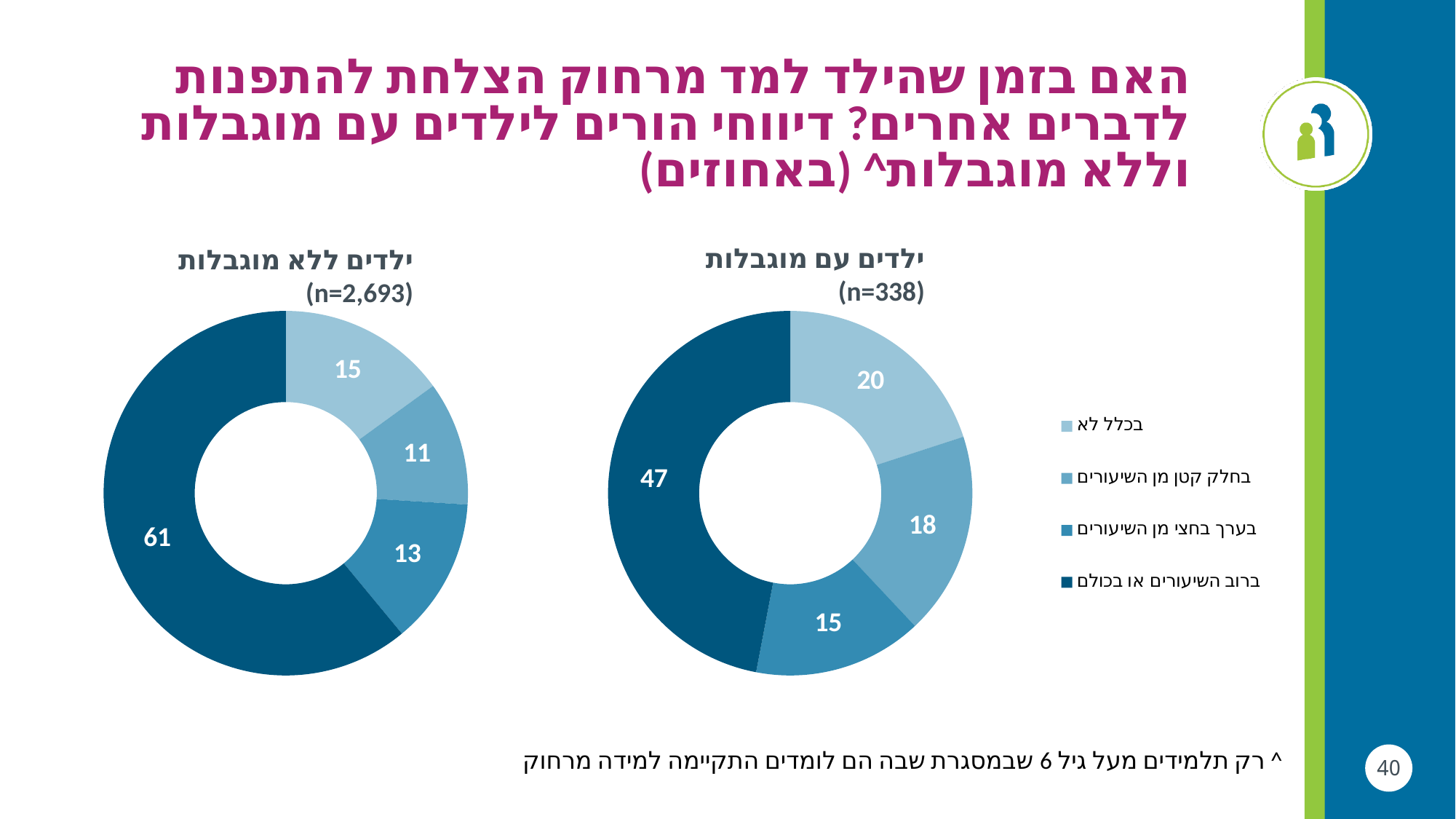
What is the difference between the 'ברוב השיעורים או בכולם' value in the 'ילדים ללא מוגבלות' chart and the same category in the 'ילדים עם מוגבלות' chart? 14 How many categories does each donut chart on the slide show? 4 In the chart titled 'ילדים עם מוגבלות (n=338)', what is the value for 'ברוב השיעורים או בכולם'? 47 How many entries does the legend on the slide list? 4 In the chart titled 'ילדים ללא מוגבלות (n=2,693)', which category has the largest share? ברוב השיעורים או בכולם In the chart titled 'ילדים ללא מוגבלות (n=2,693)', what is the value for 'בכלל לא'? 15 In the chart titled 'ילדים עם מוגבלות (n=338)', which category has the smallest share? בערך בחצי מן השיעורים In the chart titled 'ילדים עם מוגבלות (n=338)', what is the value for 'בחלק קטן מן השיעורים'? 18 In the chart titled 'ילדים ללא מוגבלות (n=2,693)', which category has the smallest share? בחלק קטן מן השיעורים Which is larger: 'בכלל לא' in the 'ילדים עם מוגבלות' chart or 'בכלל לא' in the 'ילדים ללא מוגבלות' chart? ילדים עם מוגבלות In the chart titled 'ילדים עם מוגבלות (n=338)', what is the difference between 'בכלל לא' and 'בערך בחצי מן השיעורים'? 5 What type of chart is used on this slide? Donut (pie) chart